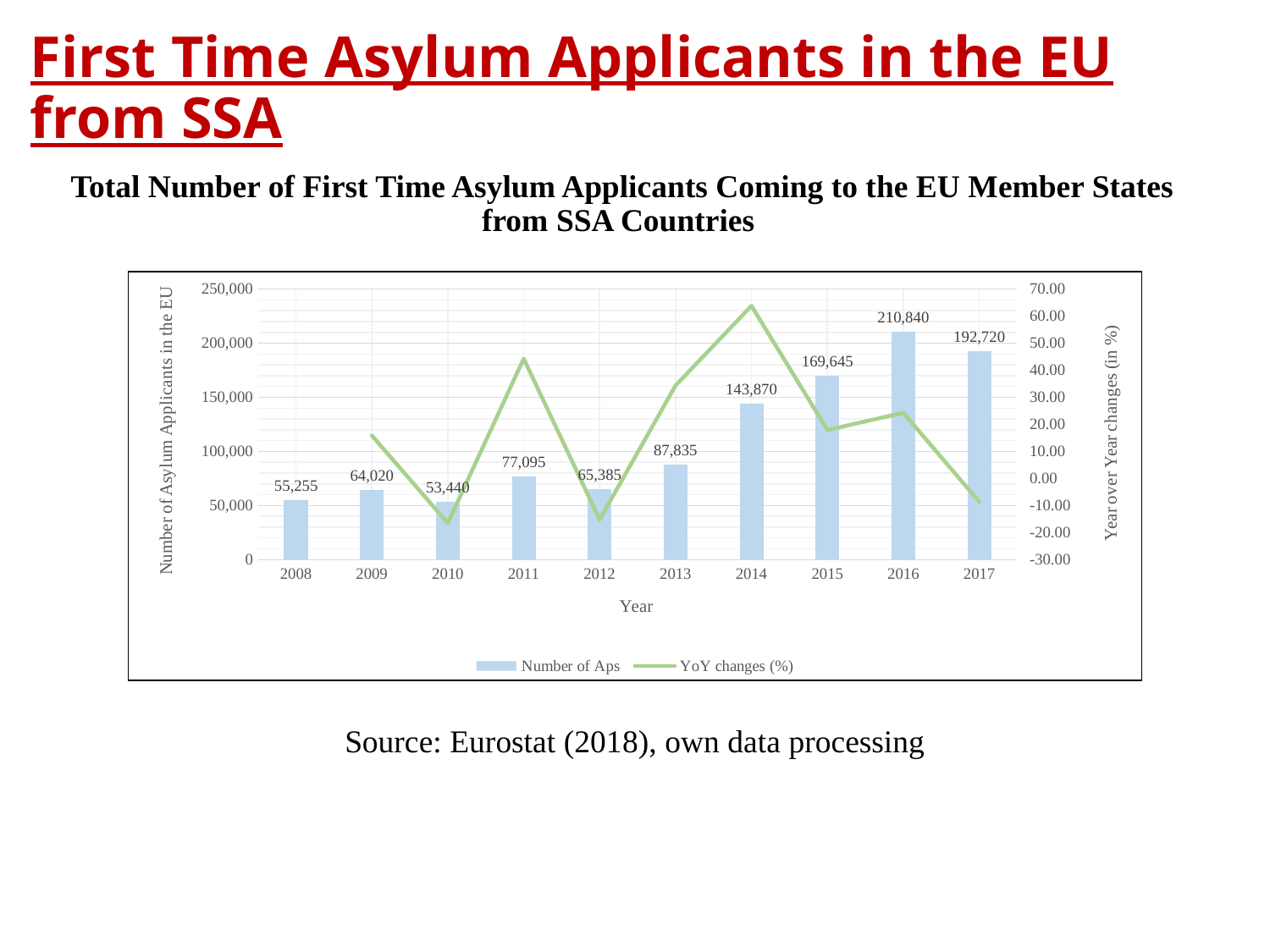
Is the YoY change (%) for 2017 greater or less than 0.00? less What is the difference between the number of applicants in 2015 and in 2014? 25,775 How many series does the chart legend list? 2 Which year has the highest number of asylum applicants? 2016 Which year had more applicants, 2009 or 2012? 2012 Is the YoY change (%) for 2014 greater or less than 50.00? greater What kind of chart is shown on the slide? A bar chart combined with a line chart By how much did the number of applicants fall from 2016 to 2017? 18,120 What is the number of first time asylum applicants from SSA in 2014? 143,870 Which year has the lowest number of asylum applicants? 2010 What is the number of first time asylum applicants from SSA in 2011? 77,095 How many years are shown on the x axis of the chart? 10